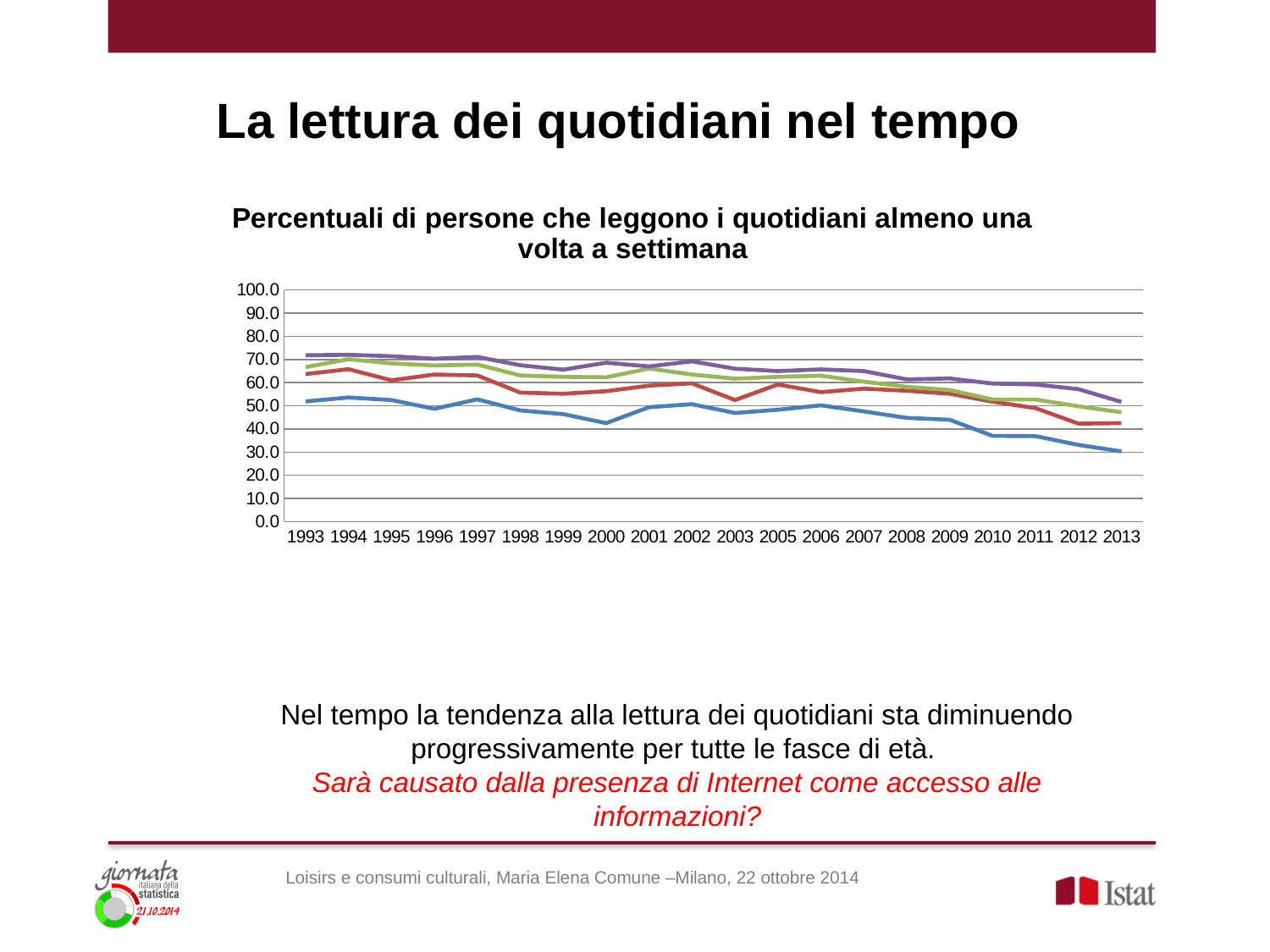
Which coloured line has the highest values across the whole period? purple Which coloured line has the lowest values across the whole period? blue Is the value of the purple line in 1993 greater or less than 60.0? greater What is the title of the chart? Percentuali di persone che leggono i quotidiani almeno una volta a settimana What kind of chart is shown on the slide? line chart Do the values of the lines generally rise or fall from 1993 to 2013? fall Is the value of the purple line in 2013 greater or less than 60.0? less Is the value of the blue line in 2013 greater or less than 40.0? less Which line is higher in 2013, the blue line or the purple line? purple How many years are shown on the x axis of the chart? 20